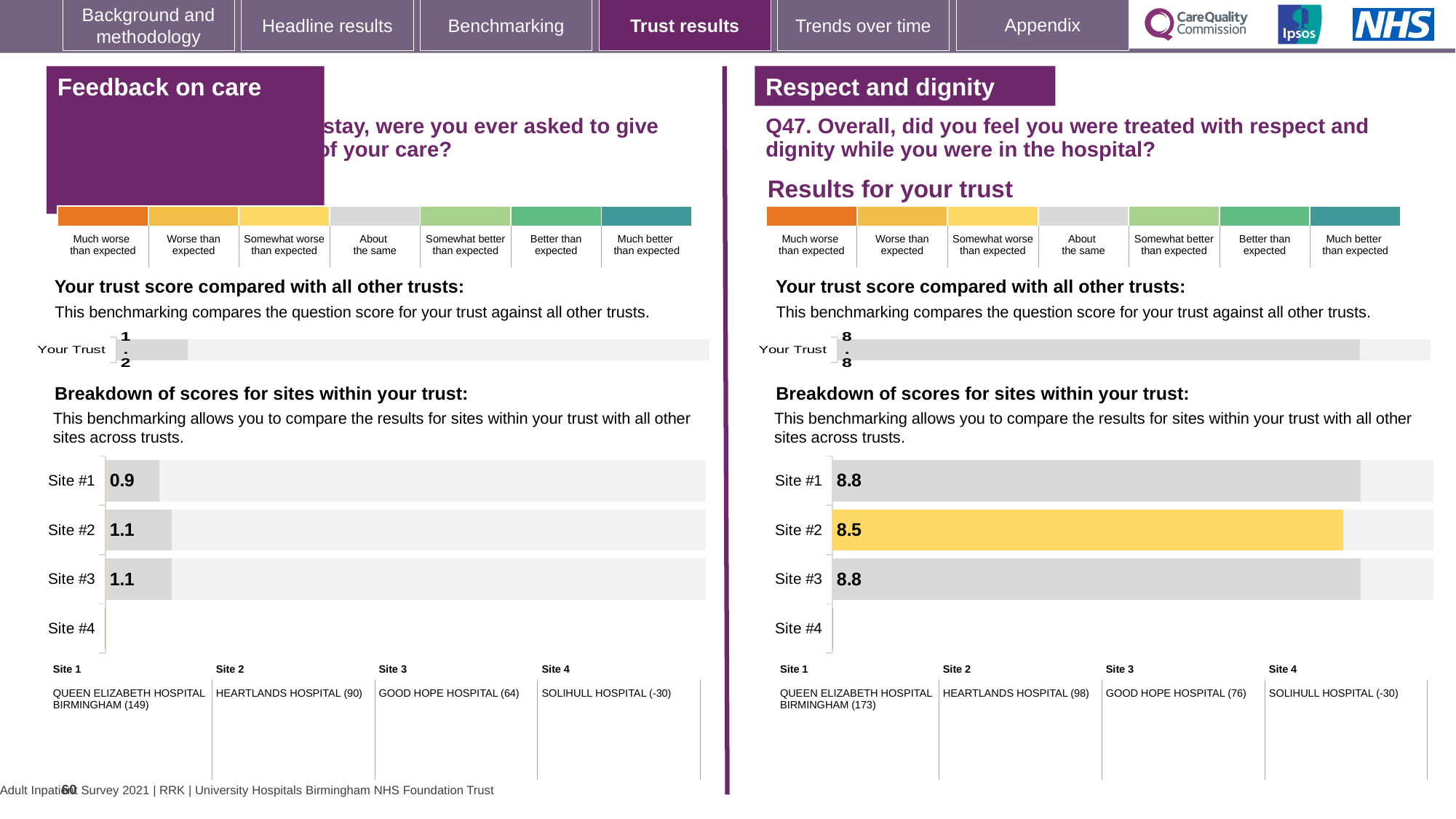
On the 'Feedback on care' panel, what is the 'Your Trust' score shown in the trust comparison chart? 1.2 In the 'Feedback on care' site breakdown chart, what is the score for Site #3? 1.1 On the 'Respect and dignity' panel, what is the 'Your Trust' score shown in the trust comparison chart? 8.8 In the 'Respect and dignity' site breakdown chart, which site has the lowest score? Site #2 In the 'Respect and dignity' site breakdown chart, is the score for Site #1 larger or smaller than the score for Site #2? larger In the 'Feedback on care' site breakdown chart, which site has the lowest score among the sites with a plotted bar? Site #1 In the 'Feedback on care' site breakdown chart, what is the score for Site #1? 0.9 In the 'Feedback on care' site breakdown chart, what is the difference between the scores for Site #2 and Site #1? 0.2 In the 'Respect and dignity' site breakdown chart, what is the difference between the scores for Site #1 and Site #2? 0.3 In the 'Respect and dignity' site breakdown chart, what is the score for Site #2? 8.5 How many site categories are listed on the axis of the 'Respect and dignity' site breakdown chart? 4 What type of chart is used for the site breakdown on the 'Feedback on care' panel? bar chart